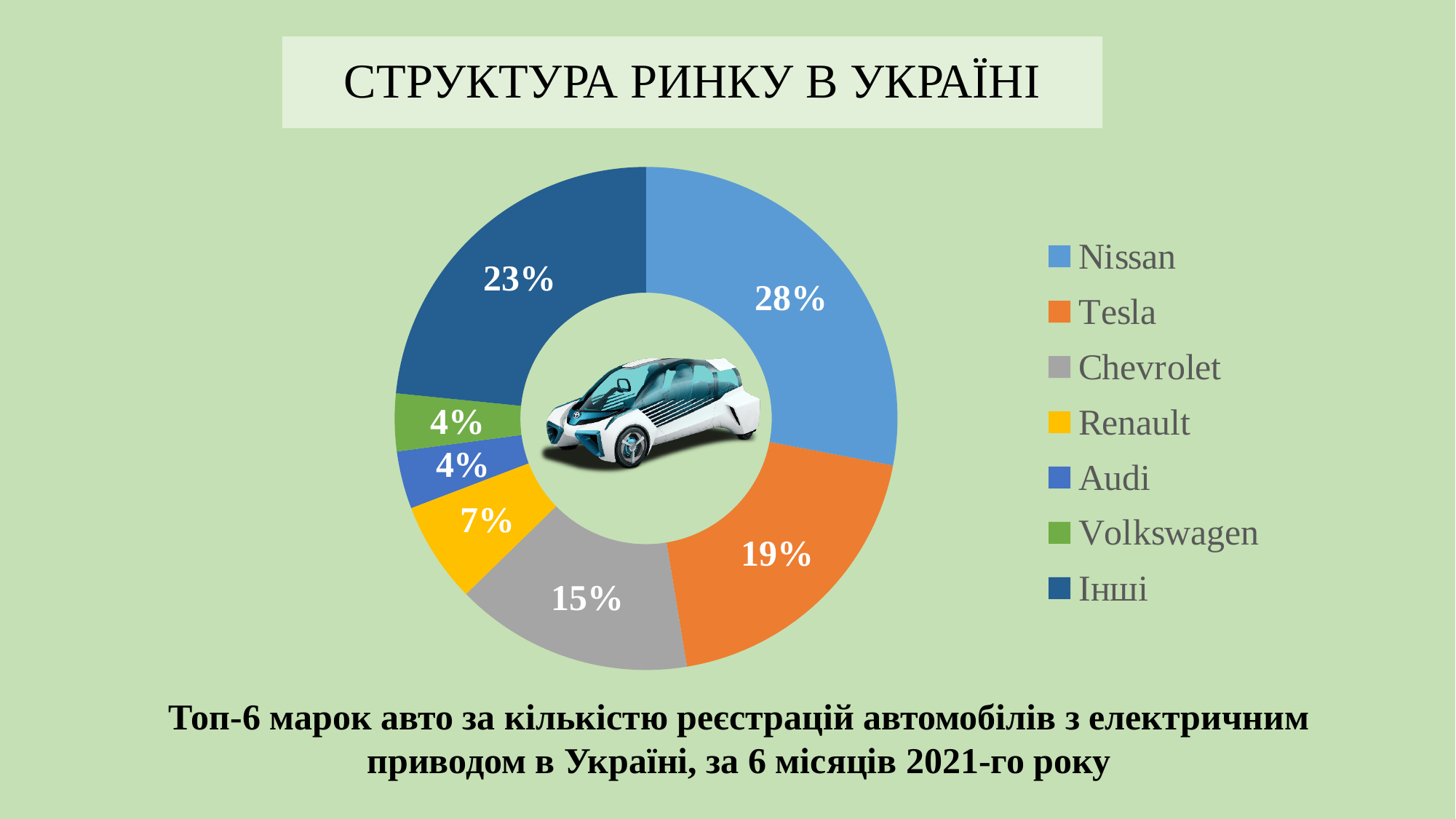
What share is shown for Renault? 7% How many slices does the chart have? 7 What is the value for Chevrolet? 15% What percentage is shown for the 'Інші' (Others) slice? 23% What is the difference between the 'Інші' slice and Chevrolet's share? 8% What share of the market does Nissan hold? 28% What percentage is shown for Tesla? 19% Which brand has the largest share in the chart? Nissan What kind of chart is shown on the slide? Pie (doughnut) chart What is the difference between Nissan's share and Tesla's share? 9% What colour is the Volkswagen slice? Green Which is larger, the share for Renault or the share for Audi? Renault